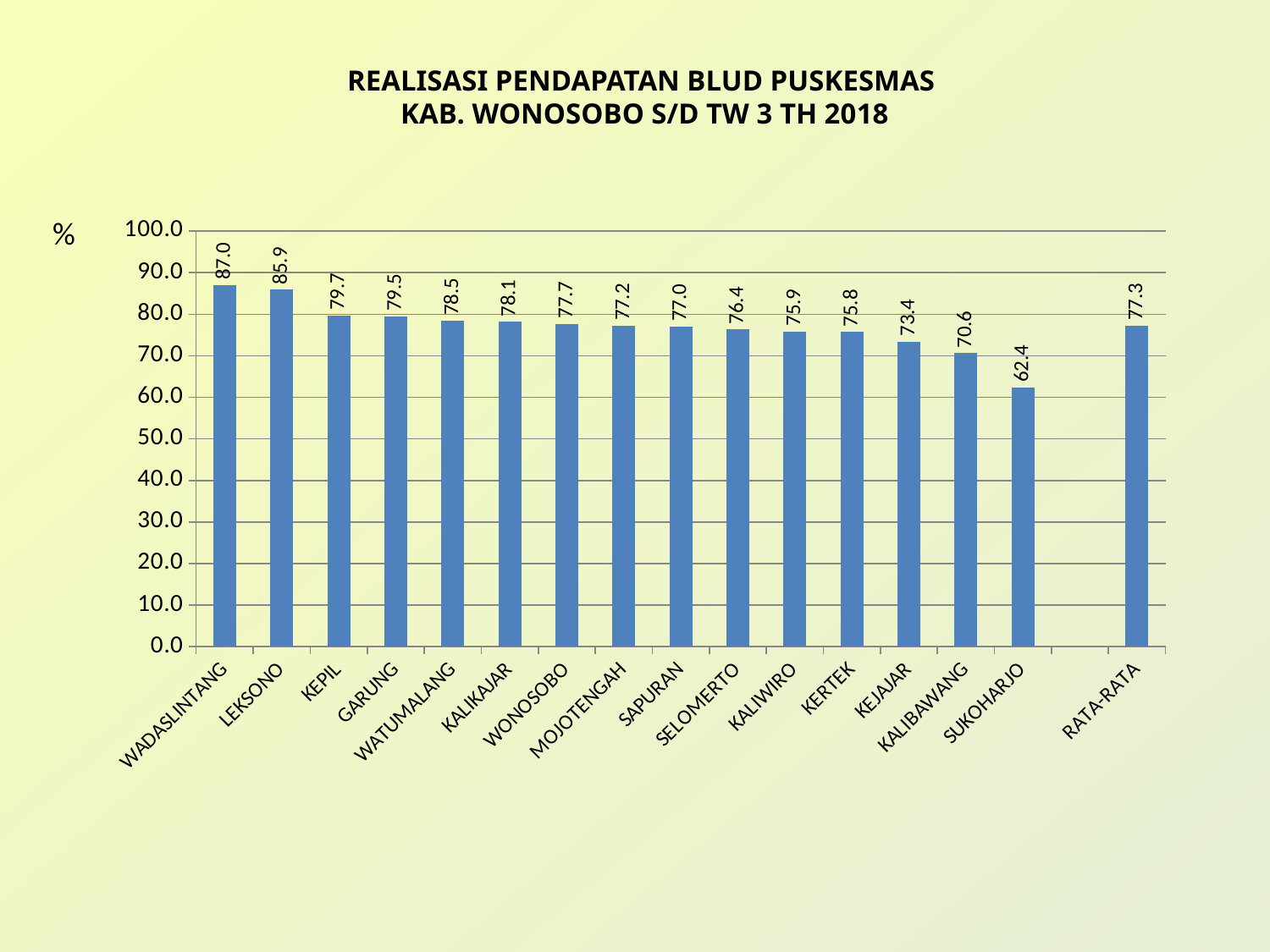
Which puskesmas has the highest value? WADASLINTANG Which is larger, the value for LEKSONO or the value for KEPIL? LEKSONO What kind of chart is shown on the slide? bar chart What is the value for KALIBAWANG? 70.6 Is the value for KEJAJAR greater or less than 80.0? less What is the difference between the values for WADASLINTANG and SUKOHARJO? 24.6 How many bars are plotted on the chart, including RATA-RATA? 16 What is the value for WADASLINTANG? 87.0 Which puskesmas has the lowest value? SUKOHARJO What is the title of the chart? REALISASI PENDAPATAN BLUD PUSKESMAS KAB. WONOSOBO S/D TW 3 TH 2018 What is the value for RATA-RATA? 77.3 What is the value for SUKOHARJO? 62.4